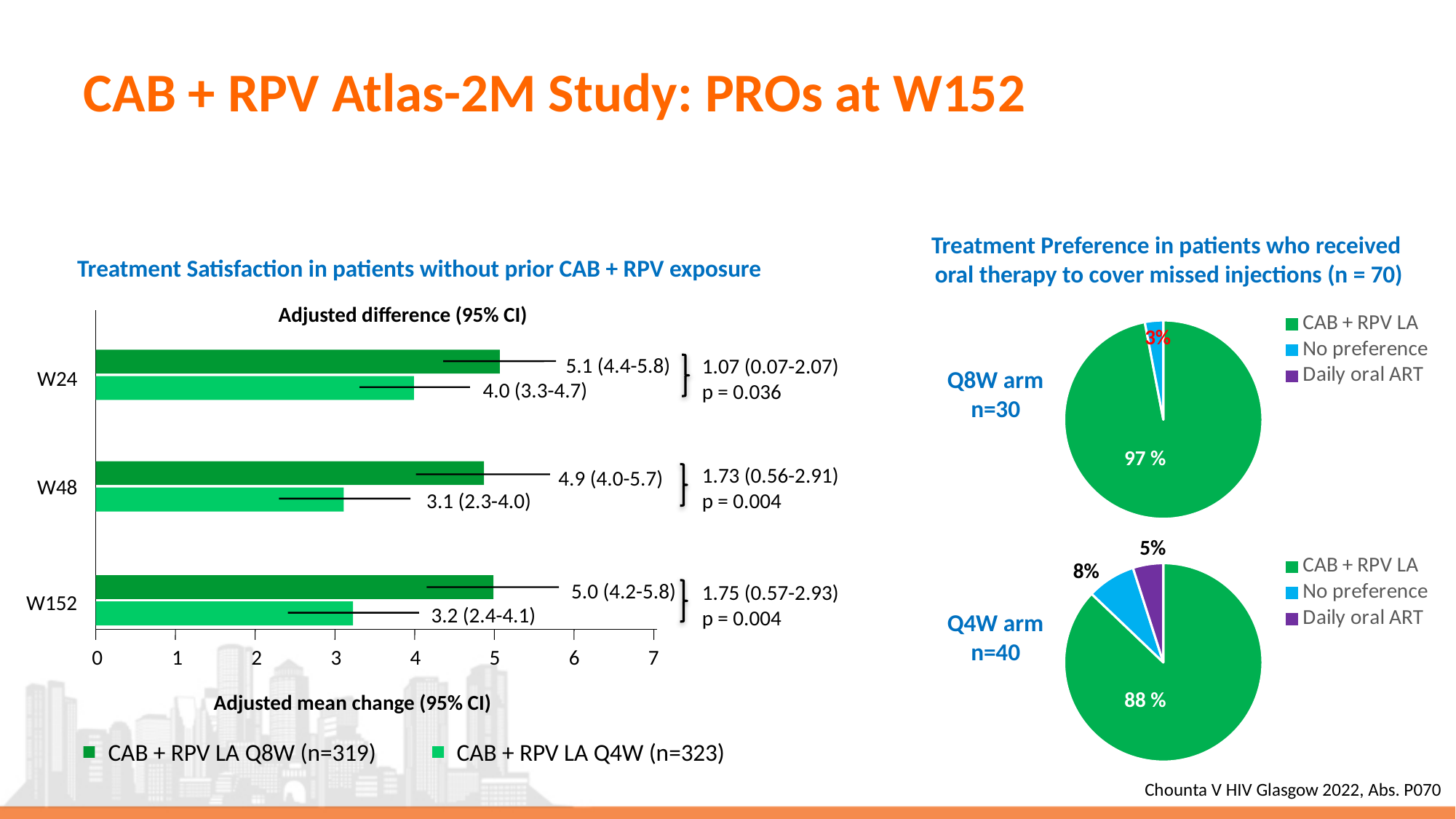
In the Treatment Satisfaction bar chart, what is the adjusted difference (95% CI) shown for W152? 1.75 (0.57-2.93) In the Treatment Satisfaction bar chart, what is the adjusted mean change for CAB + RPV LA Q4W at W48? 3.1 What kind of chart is the Treatment Satisfaction chart? Bar chart In the Q4W arm pie chart, what share of patients had no preference? 8% In the Treatment Satisfaction bar chart, at which time point is the CAB + RPV LA Q4W value lowest? W48 In the Treatment Satisfaction bar chart, which is larger at W24: the Q8W value or the Q4W value? Q8W In the Treatment Satisfaction bar chart, how many series does the legend list? 2 In the Q8W arm pie chart, what share of patients preferred CAB + RPV LA? 97 % In the Treatment Satisfaction bar chart, what is the difference between the Q8W and Q4W adjusted mean change at W48? 1.8 In the Q4W arm pie chart, what share of patients preferred daily oral ART? 5% In the Treatment Satisfaction bar chart, what is the adjusted mean change for CAB + RPV LA Q4W at W152? 3.2 In the Treatment Satisfaction bar chart, what is the adjusted mean change for CAB + RPV LA Q8W at W24? 5.1